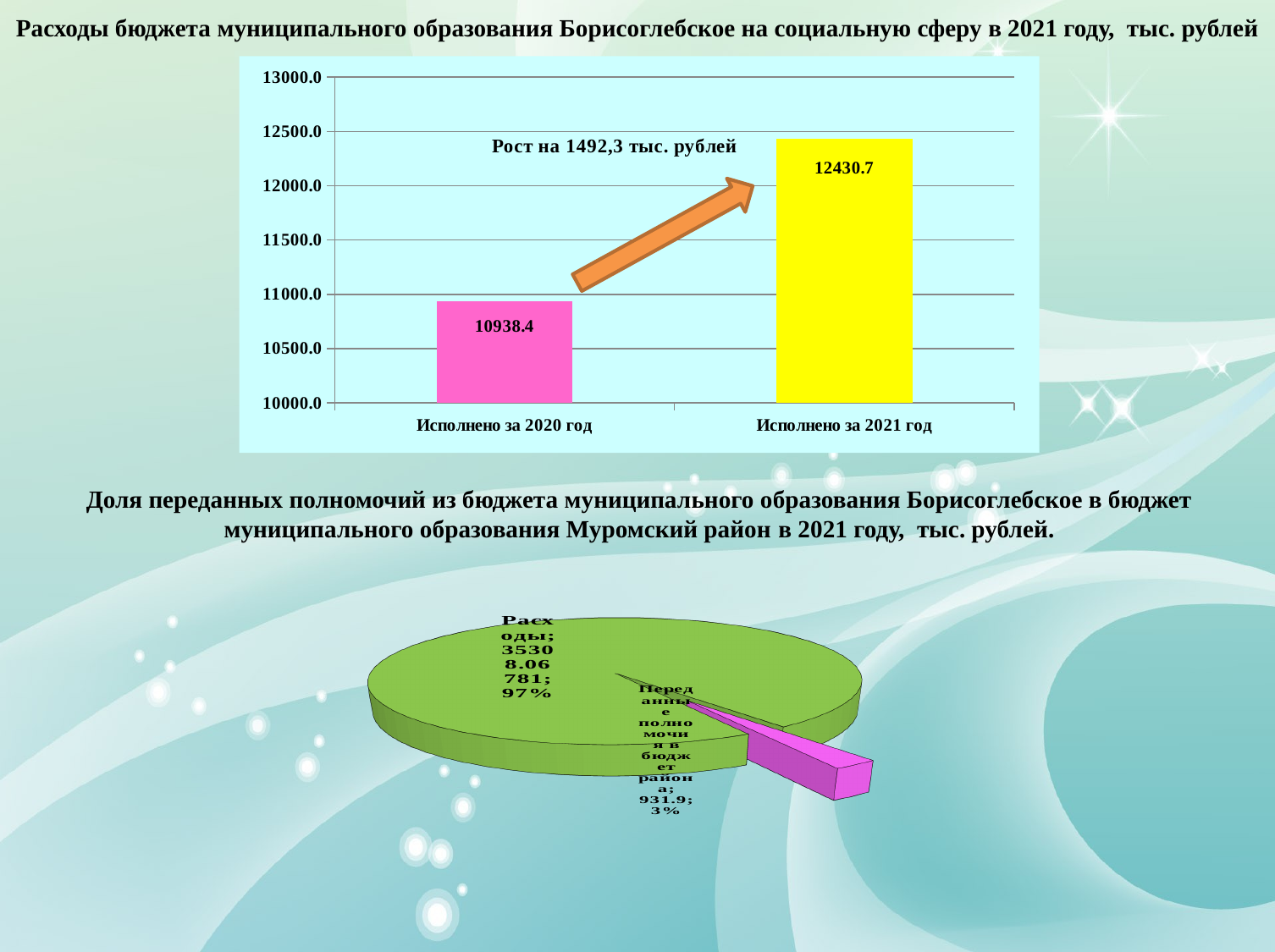
In the top bar chart, what is the value for 'Исполнено за 2020 год'? 10938.4 In the top bar chart, how many bars are plotted? 2 In the top bar chart, is the value for 'Исполнено за 2020 год' greater or less than 11000.0? less In the top bar chart, what is the value for 'Исполнено за 2021 год'? 12430.7 In the top bar chart, which category has the higher value? Исполнено за 2021 год In the top bar chart, do the values rise or fall from 2020 to 2021? rise In the bottom pie chart, what share does 'Расходы' have? 97% In the bottom pie chart, what is the value of the 'Переданные полномочия в бюджет района' slice? 931.9 In the top bar chart, what is the difference between the 2021 and 2020 values? 1492.3 What type of chart is the bottom chart on the slide? pie chart In the top bar chart, which category has the lowest value? Исполнено за 2020 год What type of chart is the top chart on the slide? bar chart